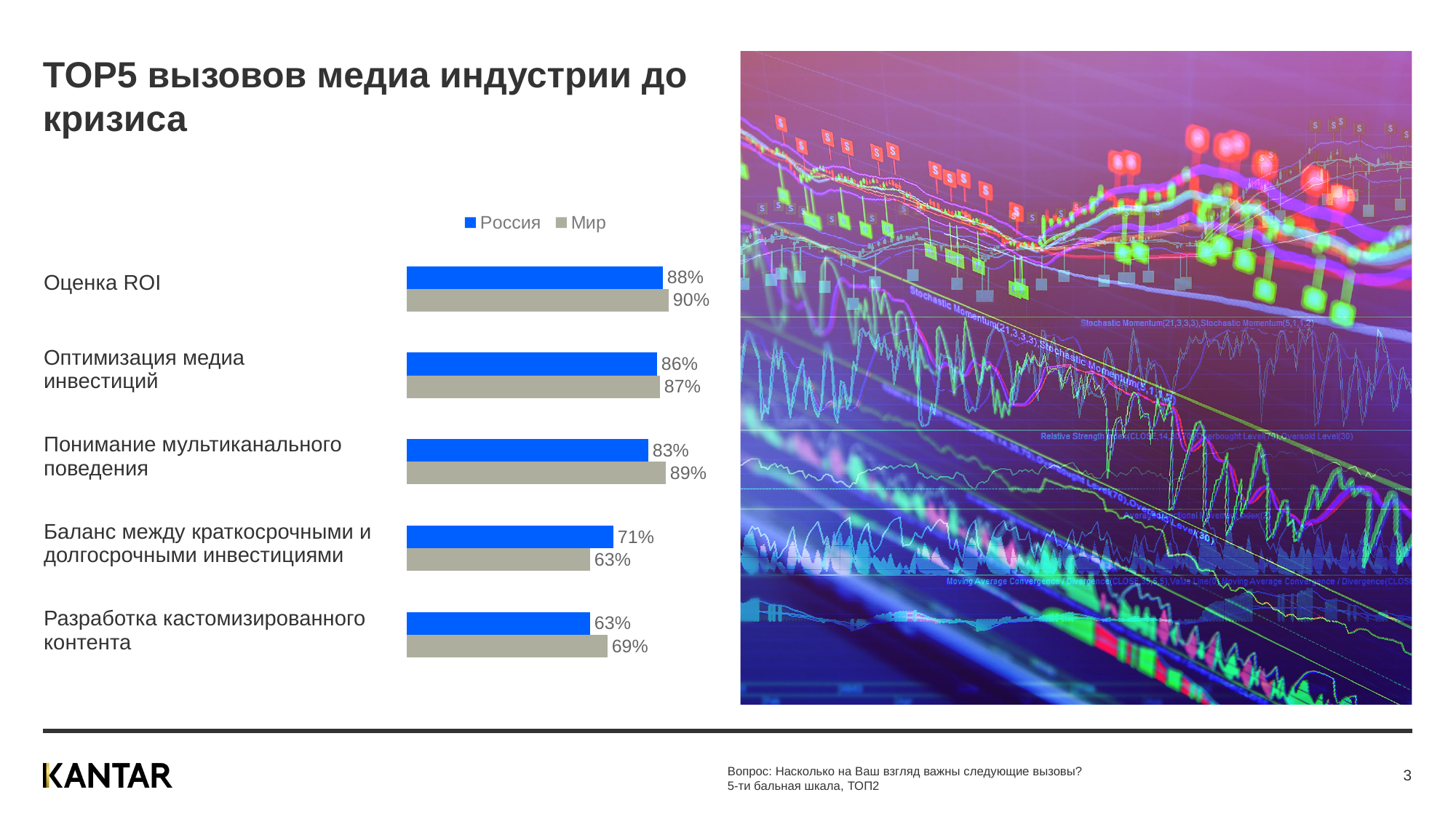
Which colour represents the Россия series in the chart? Blue How many categories are shown in the chart? 5 How many series does the legend list? 2 What is the difference between the Мир and Россия values for Понимание мультиканального поведения? 6% Which category has the lowest value for Россия? Разработка кастомизированного контента Which category has the highest value for Мир? Оценка ROI For Баланс между краткосрочными и долгосрочными инвестициями, which is larger: Россия or Мир? Россия What is the value for Россия for Баланс между краткосрочными и долгосрочными инвестициями? 71% What is the value for Мир for Разработка кастомизированного контента? 69% What kind of chart is shown on the slide? Bar chart What is the value for Мир for Понимание мультиканального поведения? 89% What is the value for Россия for Оценка ROI? 88%